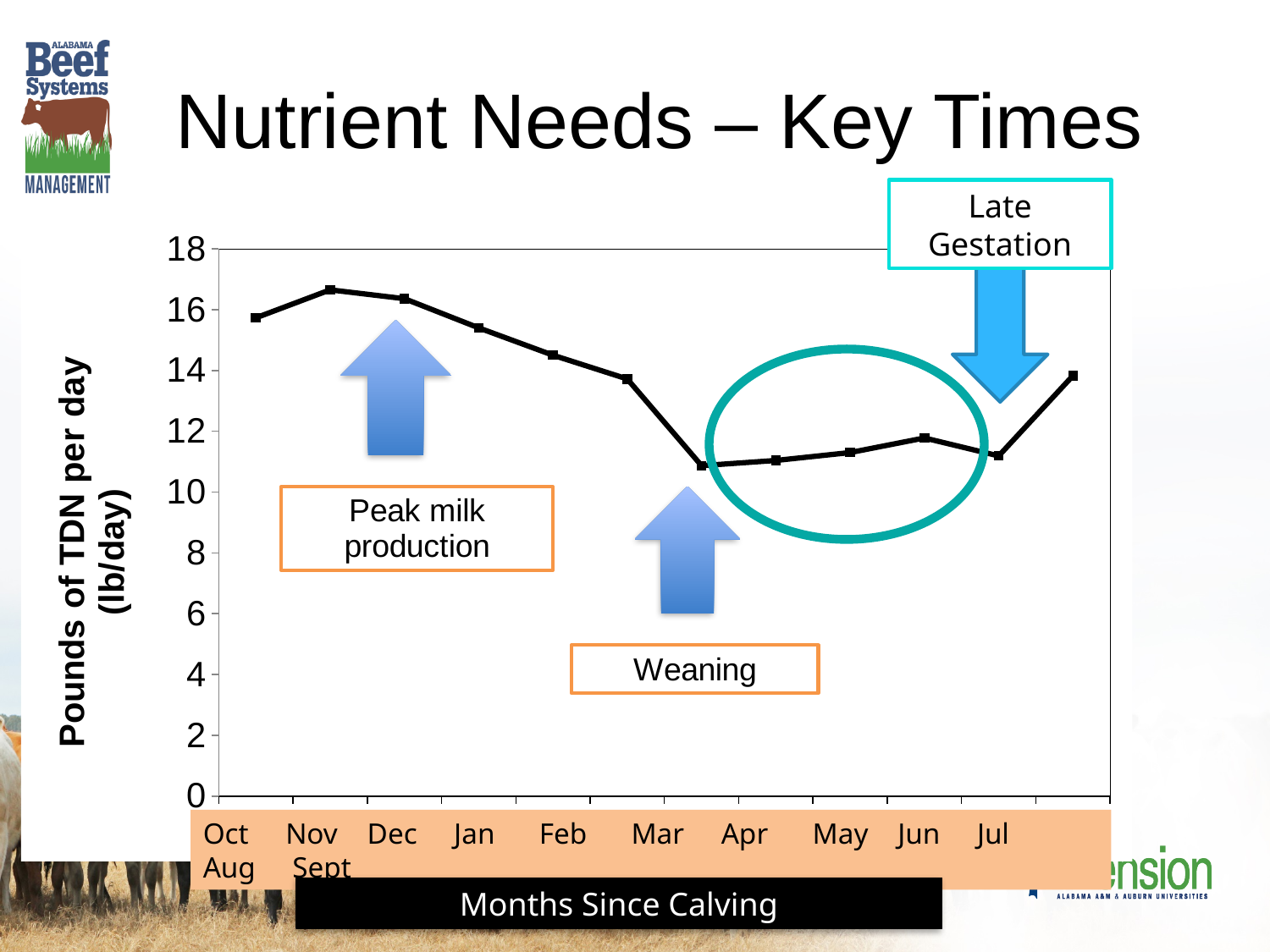
What is the title of the vertical axis? Pounds of TDN per day (lb/day) Is the value of the first plotted point (at the left of the line) greater or less than 14? greater Does the line rise or fall between the lowest point and the last plotted point? rise What is the title of the horizontal axis? Months Since Calving How many data points are plotted on the line? 12 Which is larger, the value of the first plotted point or the value of the last plotted point? the first plotted point Does the line rise or fall between the second plotted point and the lowest point near the 'Weaning' arrow? fall Is the value of the last plotted point (at the right of the line) greater or less than 12? greater Is the highest value on the line greater or less than 16? greater What kind of chart is shown on the slide? line chart